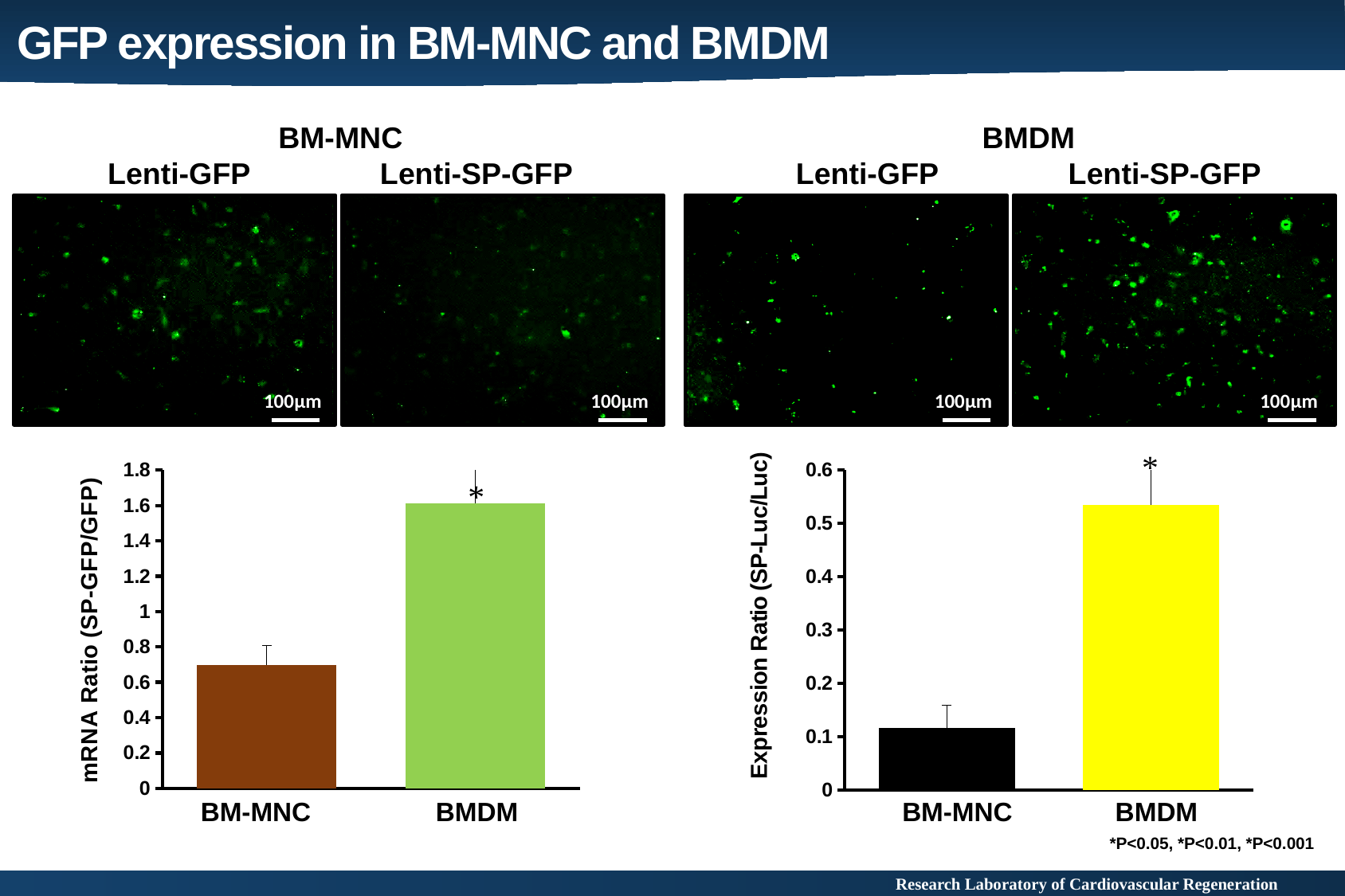
In the left chart (mRNA Ratio), is the value for BMDM greater or less than 1.4? greater In the right chart (Expression Ratio), which is larger, the value for BM-MNC or the value for BMDM? BMDM In the left chart (mRNA Ratio), is the value for BM-MNC greater or less than 1? less In the left chart (mRNA Ratio), which category has the highest value? BMDM In the right chart (Expression Ratio), which category has the highest value? BMDM In the right chart (Expression Ratio), is the value for BMDM greater or less than 0.4? greater In the left chart (mRNA Ratio), how many categories are plotted? 2 In the right chart, what colour is the BMDM bar? yellow In the left chart, what is the y-axis title? mRNA Ratio (SP-GFP/GFP) In the left chart (mRNA Ratio), what kind of chart is shown? bar chart In the left chart (mRNA Ratio), which category has the lowest value? BM-MNC